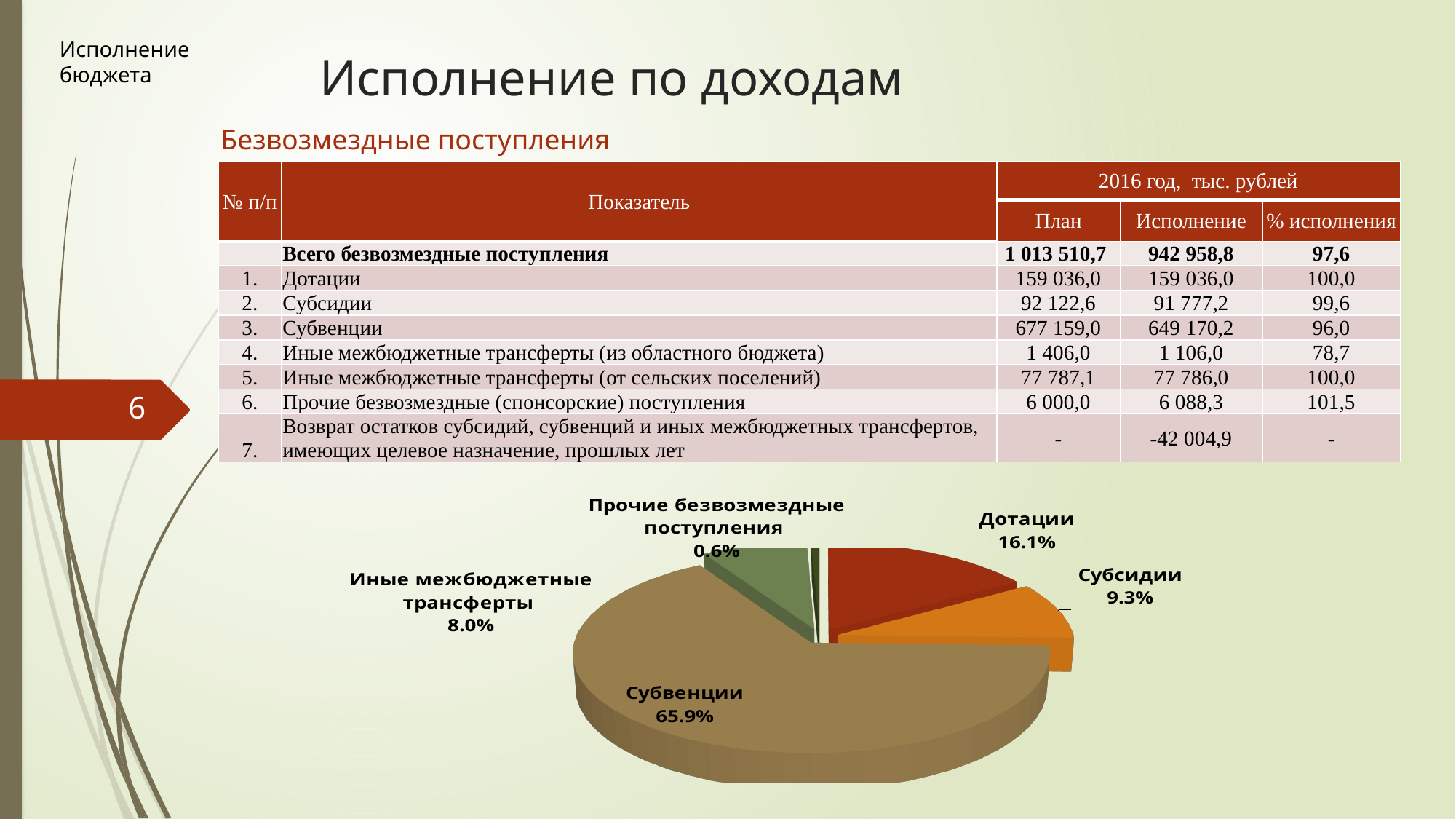
What share of the pie does Прочие безвозмездные поступления have? 0.6% What share of the pie does Иные межбюджетные трансферты have? 8.0% What share of the pie does Субсидии have? 9.3% What share of the pie does Дотации have? 16.1% What share of the pie does Субвенции have? 65.9% What colour is the Субвенции slice in the pie chart? Brown What is the difference in percentage points between the Дотации and Субсидии slices? 6.8 What kind of chart is shown on the slide? Pie chart Which slice of the pie chart is the largest? Субвенции How many slices does the pie chart have? 5 Which slice of the pie chart is the smallest? Прочие безвозмездные поступления Which is larger in the pie chart, Дотации or Субсидии? Дотации